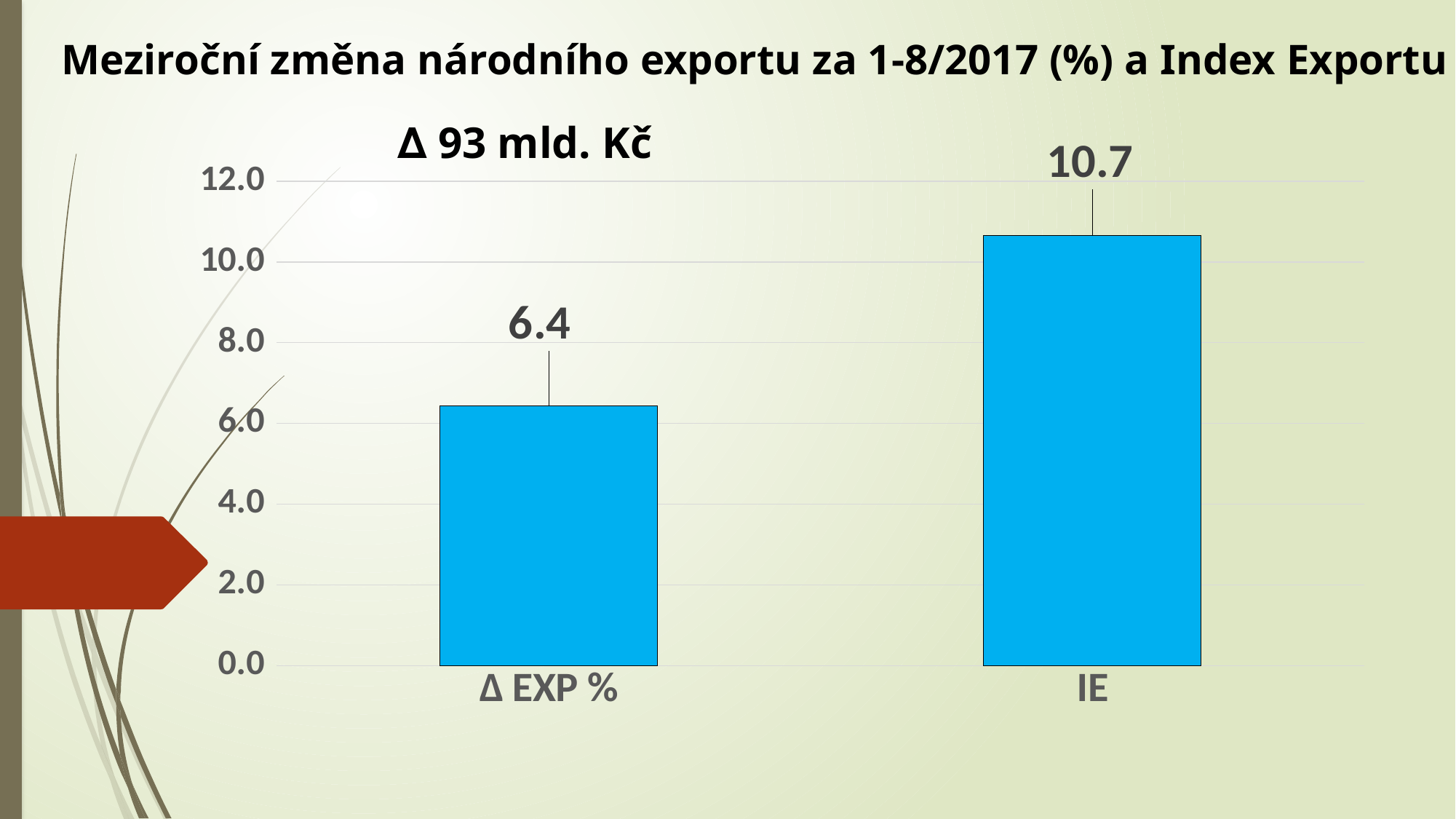
What is the highest tick value shown on the y axis? 12.0 How many categories are shown on the x axis? 2 What is the value for IE? 10.7 Is the value for IE greater or less than 10.0? greater What kind of chart is shown on the slide? bar chart Which is larger, the value for Δ EXP % or the value for IE? IE Which category has the highest value? IE Is the value for Δ EXP % greater or less than 8.0? less What is the difference between the values for IE and Δ EXP %? 4.3 What is the value for Δ EXP %? 6.4 What text is shown above the chart next to the Δ EXP % bar? Δ 93 mld. Kč Which category has the lowest value? Δ EXP %